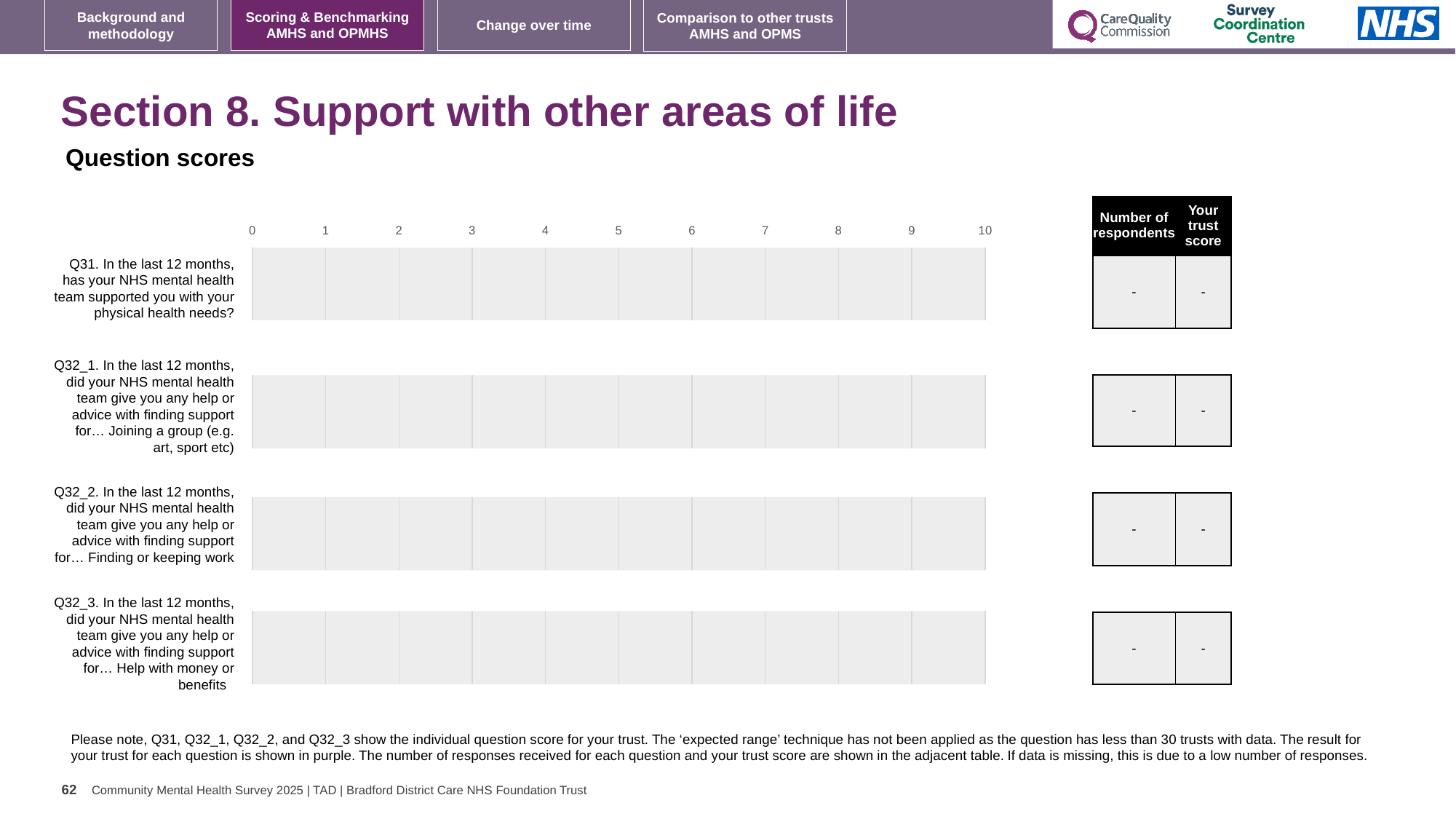
What value is shown in the 'Number of respondents' column for Q32_3? - What value is shown in the 'Number of respondents' column for Q32_1? - What kind of chart is shown on the slide? bar chart How many question categories are listed on the chart's vertical axis? 4 What value is shown in the 'Your trust score' column for Q31? - What value is shown in the 'Your trust score' column for Q32_2? - What is the lowest value shown on the chart's horizontal axis? 0 What is the highest value shown on the chart's horizontal axis? 10